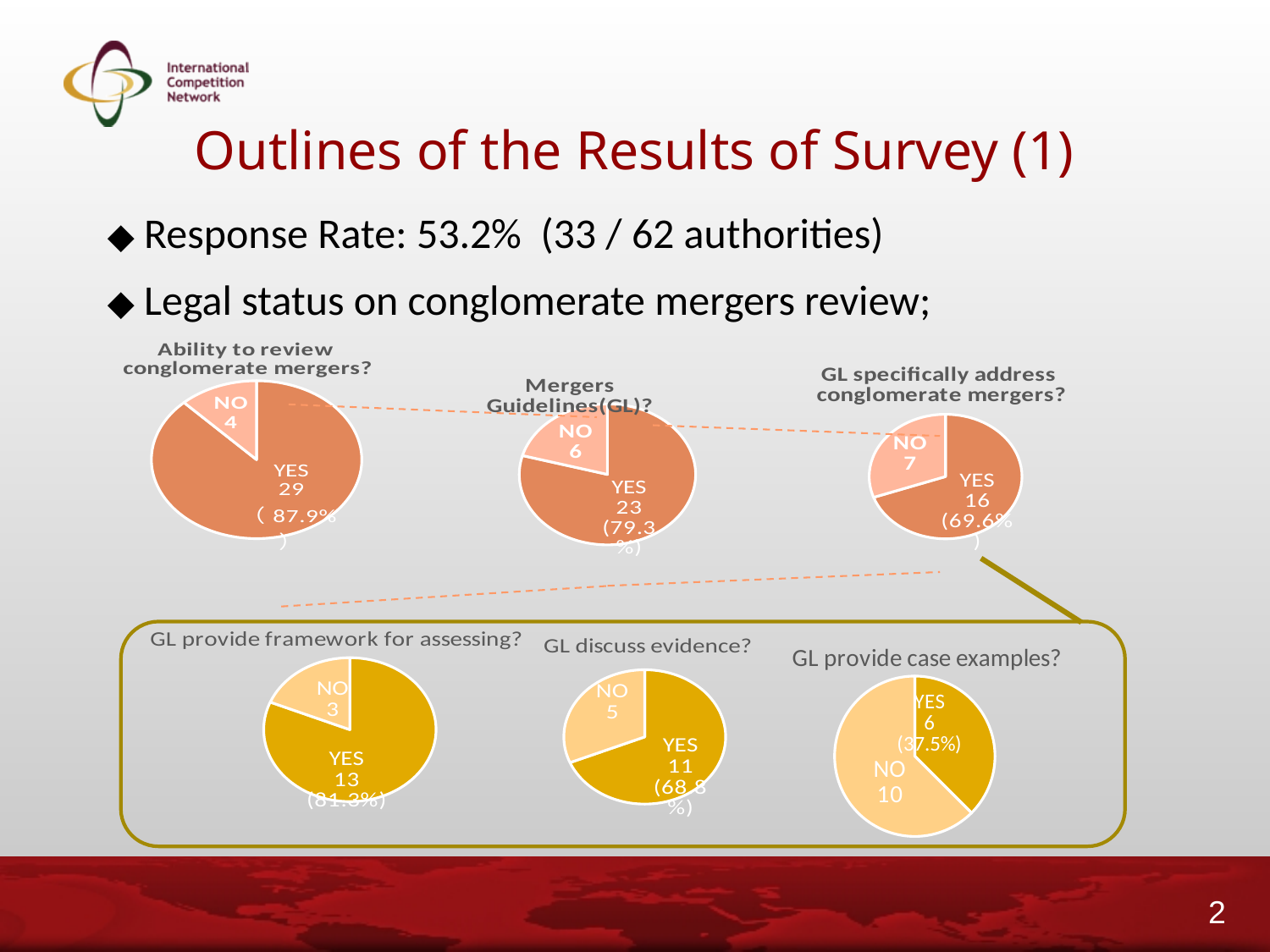
In the 'Ability to review conglomerate mergers?' pie chart, how many authorities answered YES? 29 In the 'Ability to review conglomerate mergers?' pie chart, what percentage share does the YES slice represent? 87.9% In the 'Mergers Guidelines(GL)?' pie chart, how many authorities answered NO? 6 In the 'GL specifically address conglomerate mergers?' pie chart, what percentage share is shown for YES? 69.6% How many pie charts are shown on the slide? 6 In the 'GL provide case examples?' pie chart, which answer has the larger slice? NO In the 'GL provide case examples?' pie chart, what percentage share is shown for YES? 37.5% In the 'GL specifically address conglomerate mergers?' pie chart, what is the value for YES? 16 In the 'Mergers Guidelines(GL)?' pie chart, what is the difference between the YES and NO counts? 17 In the 'GL provide framework for assessing?' pie chart, which slice is larger, YES or NO? YES In the 'GL discuss evidence?' pie chart, how many authorities answered NO? 5 What type of chart is used for 'GL discuss evidence?' Pie chart